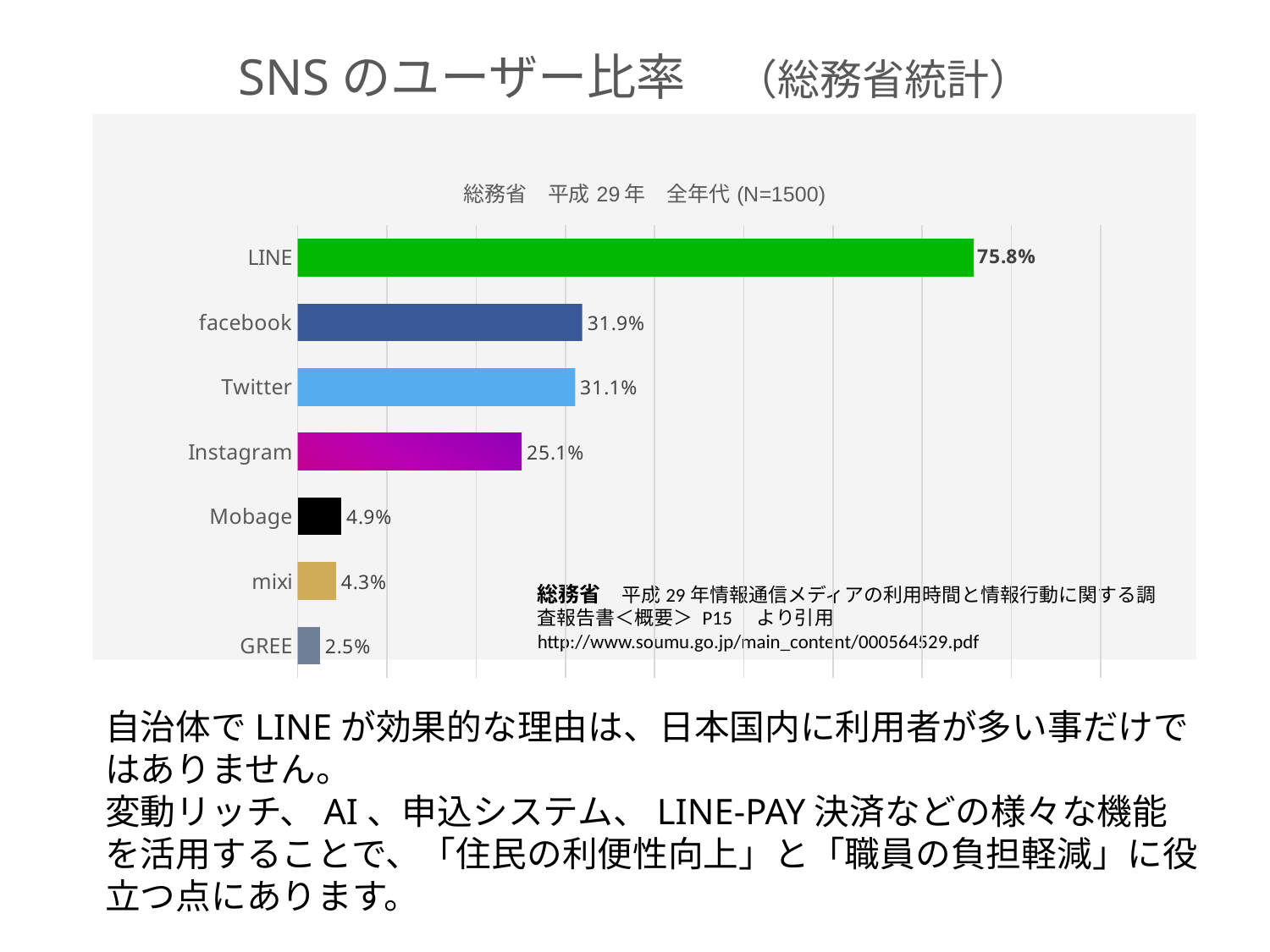
Which SNS has the lowest user ratio? GREE What is the value for Instagram? 25.1% What kind of chart is shown on the slide? Bar chart What is the value for mixi? 4.3% How many SNS categories are shown in the chart? 7 Which SNS has the highest user ratio? LINE Which is larger, the value for Twitter or the value for Instagram? Twitter What is the difference between the values for Mobage and GREE? 2.4% What colour is the bar for LINE? Green What is the difference between the values for LINE and facebook? 43.9% What is the sample size (N) stated in the chart's subtitle? N=1500 What is the value for LINE? 75.8%